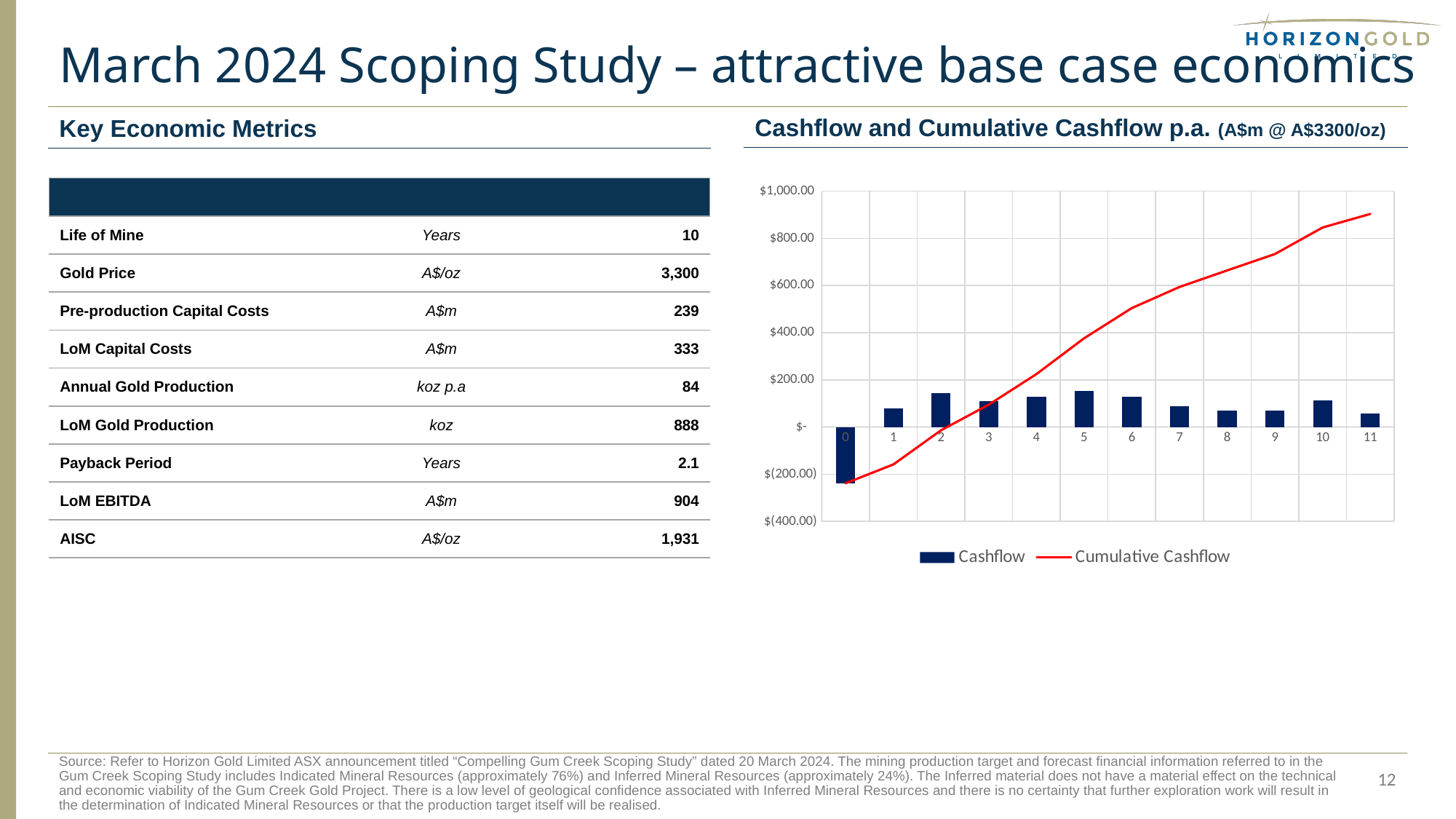
In the 'Cashflow and Cumulative Cashflow p.a.' chart, is the Cumulative Cashflow at year 3 greater or less than $200.00? less In the 'Cashflow and Cumulative Cashflow p.a.' chart, which year has the lowest Cashflow? 0 How many years (categories) are shown on the x axis of the 'Cashflow and Cumulative Cashflow p.a.' chart? 12 In the 'Cashflow and Cumulative Cashflow p.a.' chart, is the Cumulative Cashflow at year 6 greater or less than $400.00? greater In the 'Cashflow and Cumulative Cashflow p.a.' chart, which has the larger Cashflow, year 0 or year 1? year 1 In the 'Cashflow and Cumulative Cashflow p.a.' chart, does the Cumulative Cashflow line rise or fall from year 0 to year 11? rise In the 'Cashflow and Cumulative Cashflow p.a.' chart, is the Cashflow for year 0 greater or less than $-? less What are the two series named in the legend of the 'Cashflow and Cumulative Cashflow p.a.' chart? Cashflow and Cumulative Cashflow What kind of chart is used to plot the Cashflow series in the 'Cashflow and Cumulative Cashflow p.a.' chart? bar chart How many series does the legend of the 'Cashflow and Cumulative Cashflow p.a.' chart list? 2 In the 'Cashflow and Cumulative Cashflow p.a.' chart, which has the larger Cashflow, year 2 or year 9? year 2